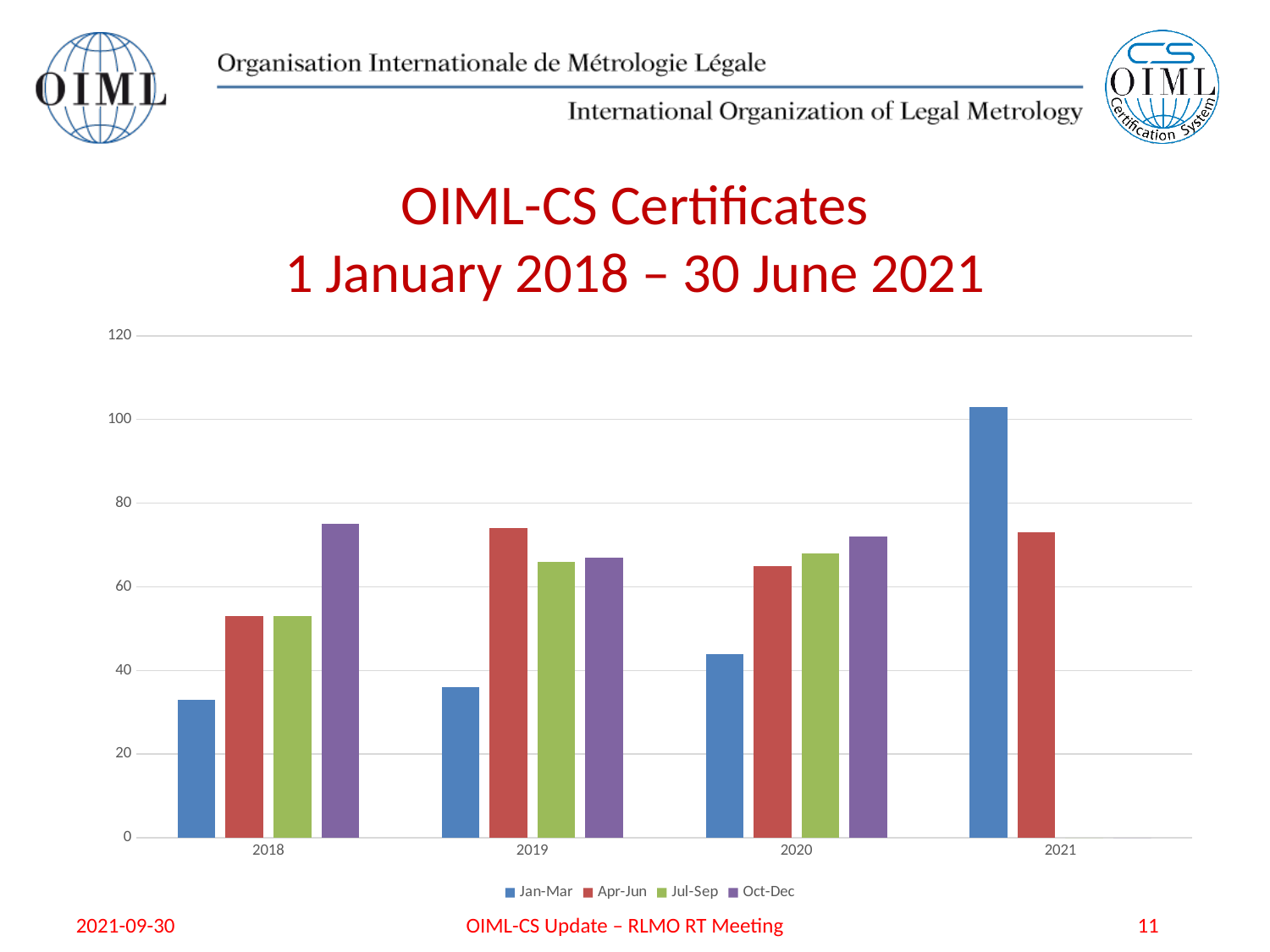
Which is larger, the Jan-Mar bar for 2021 or the Apr-Jun bar for 2021? Jan-Mar Within 2018, which quarter has the lowest bar? Jan-Mar Is the value for Jan-Mar 2021 greater or less than 100? greater Within 2018, which quarter has the highest bar? Oct-Dec Is the value for Oct-Dec 2018 greater or less than 80? less Which series and year has the highest bar in the chart? Jan-Mar 2021 How many series does the legend list? 4 What kind of chart is shown on the slide? bar chart What are the four legend entries of the chart? Jan-Mar, Apr-Jun, Jul-Sep, Oct-Dec How many year categories are shown on the x axis? 4 Is the value for Jan-Mar 2018 greater or less than 40? less Does the Jan-Mar series rise or fall from 2018 to 2021? rises